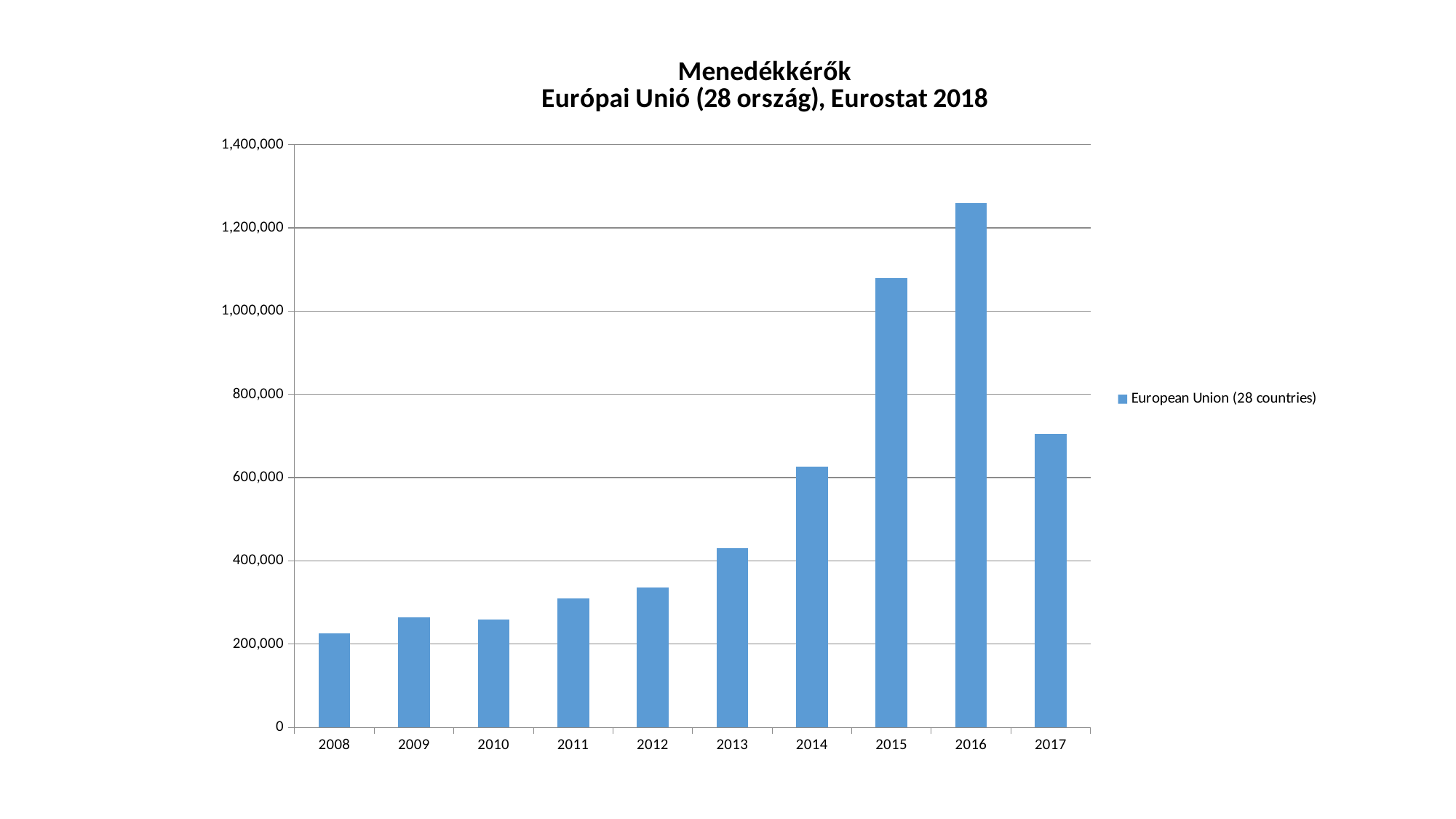
Is the value for 2016 greater or less than 1,200,000? greater Is the value for 2014 greater or less than 600,000? greater Which year has the highest number of asylum seekers? 2016 How many years are shown on the x axis? 10 Is the value for 2015 greater or less than 1,000,000? greater Do the values rise or fall from 2013 to 2016? rise How many series does the legend list? 1 Which year has the lowest number of asylum seekers? 2008 Which year has the larger value, 2015 or 2017? 2015 What kind of chart is shown on the slide? bar chart